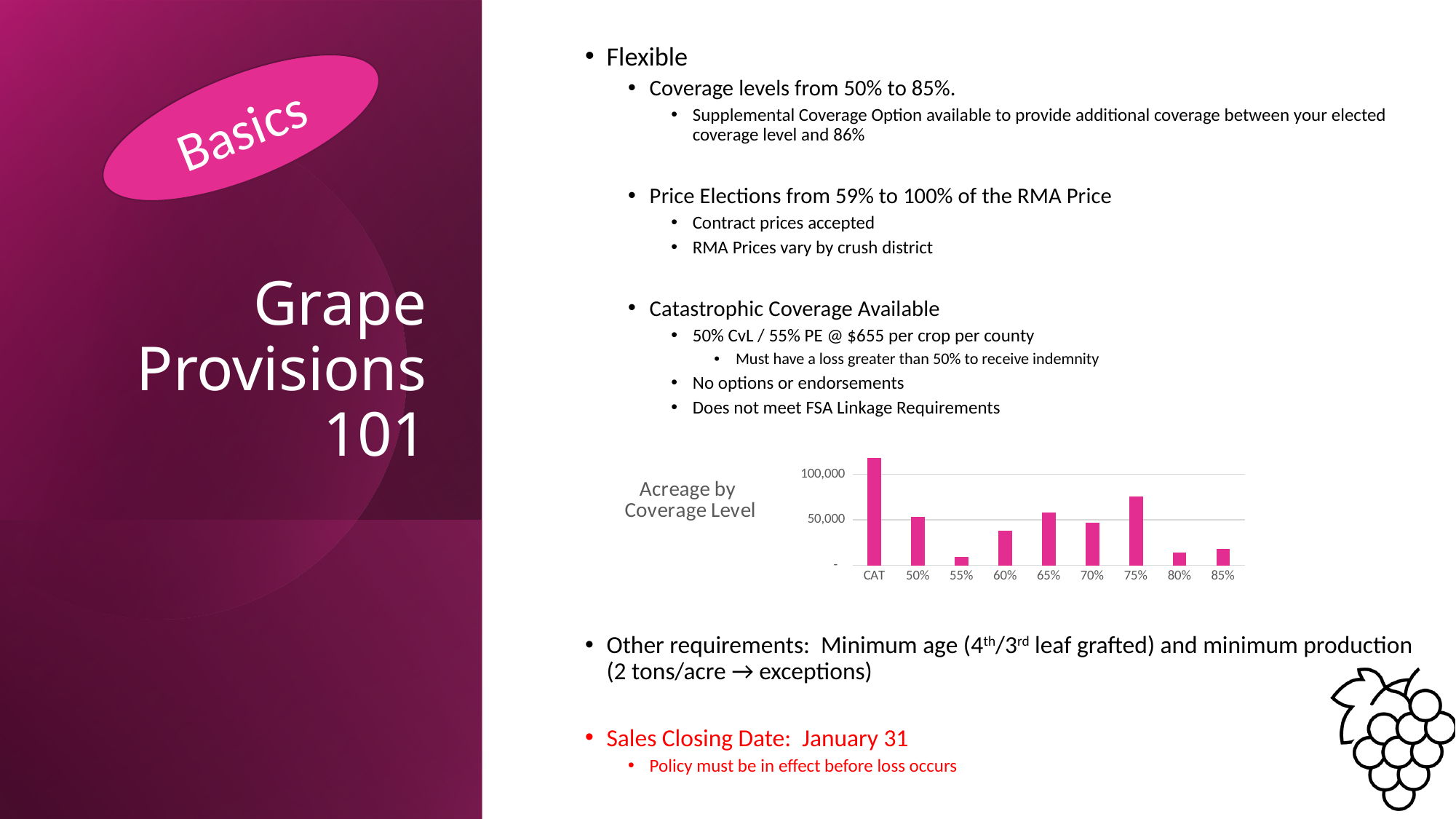
Is the acreage for CAT greater or less than 100,000? greater Which has more acreage, CAT or the 75% coverage level? CAT Which has more acreage, the 75% coverage level or the 50% coverage level? 75% Is the acreage for the 75% coverage level greater or less than 50,000? greater Which coverage level has the lowest acreage in the chart? 55% Which coverage level has the highest acreage in the chart? CAT How many coverage level categories are shown on the x axis of the chart? 9 What kind of chart is shown on the slide? bar chart Which has more acreage, the 65% coverage level or the 60% coverage level? 65% Is the acreage for the 60% coverage level greater or less than 50,000? less What is the title of the chart on the slide? Acreage by Coverage Level